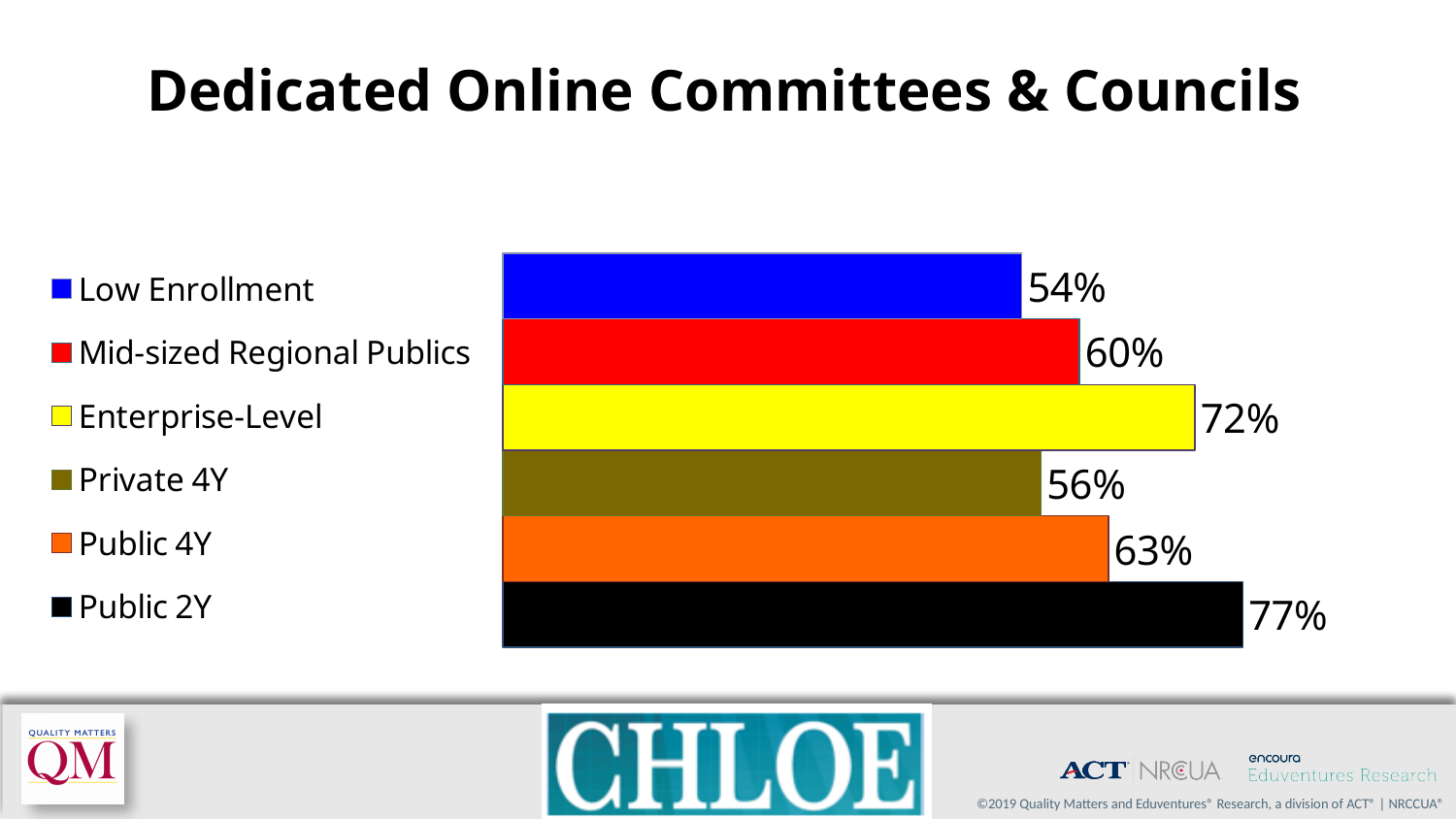
Which category has the highest value? Public 2Y What is the difference between the values for Public 4Y and Mid-sized Regional Publics? 3% What kind of chart is shown on the slide? Bar chart What is the value for Public 2Y? 77% Which is larger, the value for Enterprise-Level or the value for Public 4Y? Enterprise-Level What is the value for Private 4Y? 56% What is the title of the chart? Dedicated Online Committees & Councils What is the value for Enterprise-Level? 72% Which category has the lowest value? Low Enrollment How many categories are shown in the chart? 6 What is the difference between the values for Public 2Y and Low Enrollment? 23% What is the value for Low Enrollment? 54%